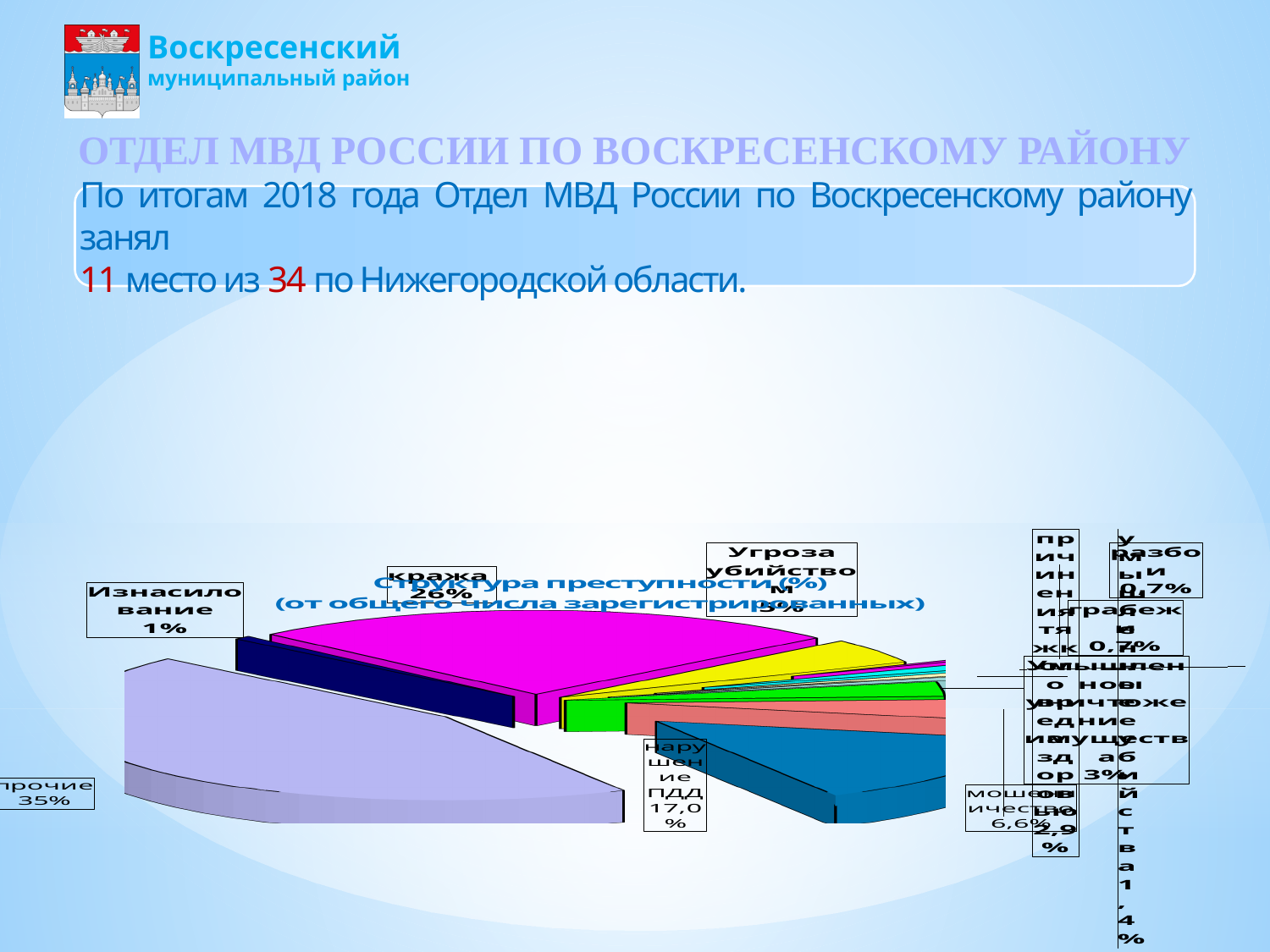
What is the difference between the values for "мошенничество" and "Угроза убийством"? 1,6% What share of the pie does "прочие" take? 35% What is the value shown for "кража"? 26% What is the value shown for "Изнасилование"? 1% What is the value shown for "нарушение ПДД"? 17,0% What is the difference between the values for "прочие" and "кража"? 9% Which is larger, the slice for "кража" or the slice for "нарушение ПДД"? кража What is the value shown for "мошенничество"? 6,6% What is the title of the chart? Структура преступности (%) (от общего числа зарегистрированных) Which category has the largest slice of the pie? прочие What kind of chart is shown on the slide? pie chart What is the value shown for "Угроза убийством"? 5%